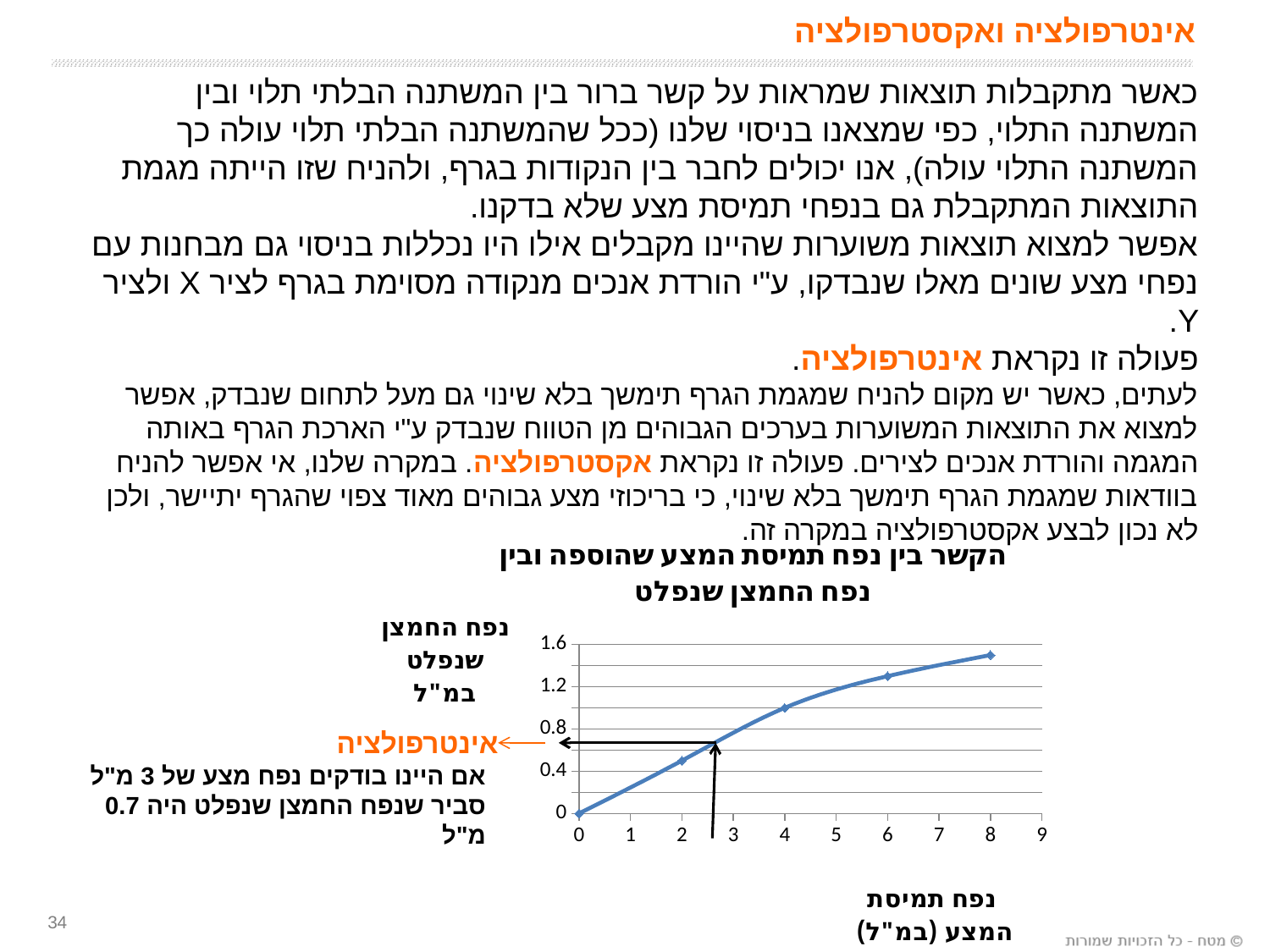
Is the oxygen volume at a substrate solution volume of 8 ml greater or less than 1.2? greater How many data points are plotted on the line? 5 What kind of chart is shown on the slide? line chart At which x-axis value (substrate solution volume) is the oxygen volume highest? 8 What is the oxygen volume plotted at a substrate solution volume of 0 ml? 0 At which x-axis value (substrate solution volume) is the oxygen volume lowest? 0 Which has a larger oxygen volume: a substrate solution volume of 4 ml or 2 ml? 4 ml Is the oxygen volume at a substrate solution volume of 2 ml greater or less than 0.8? less Do the values rise or fall as the substrate solution volume (x axis) increases? rise Is the oxygen volume at a substrate solution volume of 4 ml greater or less than 0.8? greater What is the highest value shown on the y axis? 1.6 According to the annotation next to the chart, what oxygen volume is estimated by interpolation for a substrate volume of 3 ml? 0.7 מ"ל